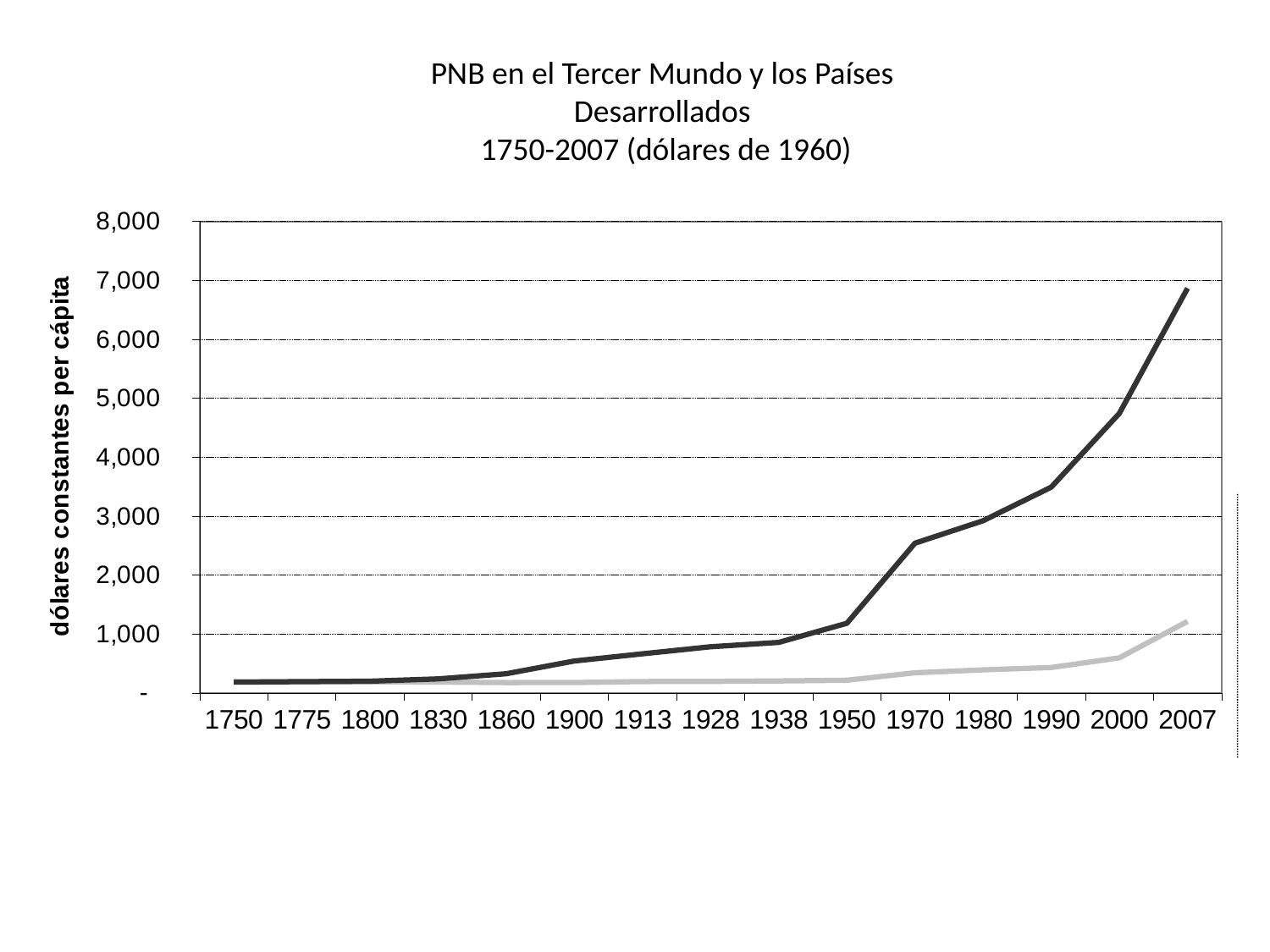
Does the dark line rise or fall from 1750 to 2007? rise Is the value of the dark line in 1950 greater or less than 2,000? less Is the value of the light gray line in 2007 greater or less than 2,000? less Is the value of the light gray line in 2000 greater or less than 1,000? less How many years are marked along the x axis of the chart? 15 What kind of chart is shown on the slide? line chart What is the label on the y axis of the chart? dólares constantes per cápita How many lines are plotted on the chart? 2 In which year does the dark line reach its highest value? 2007 In 2007, which line has the larger value, the dark line or the light gray line? the dark line